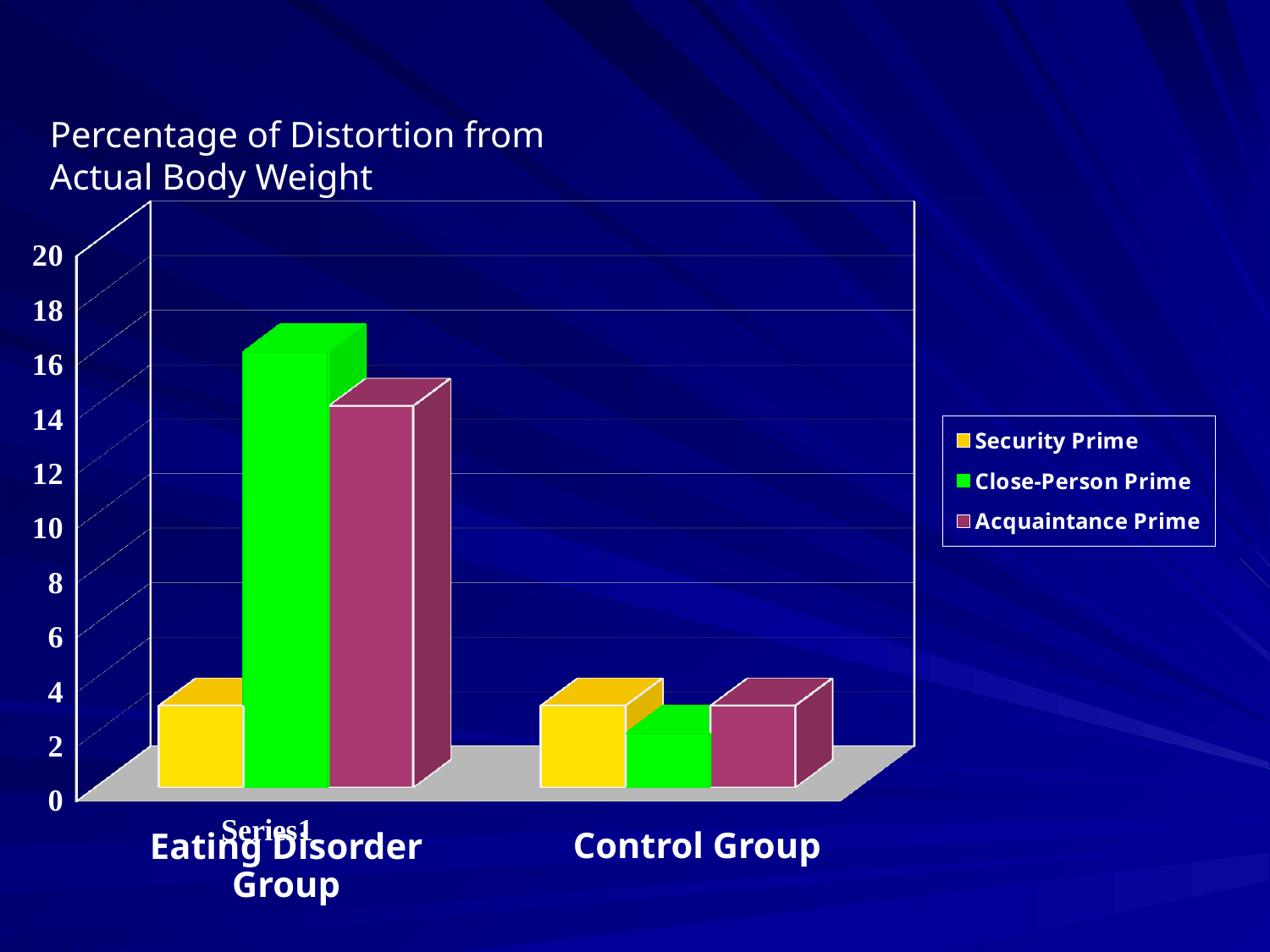
Is the value for Close-Person Prime in the Eating Disorder Group greater or less than 10? greater Within the Eating Disorder Group, which prime condition has the highest value? Close-Person Prime How many series does the legend list? 3 Which is larger: the Close-Person Prime value for the Eating Disorder Group or for the Control Group? Eating Disorder Group Is the value for Security Prime in the Eating Disorder Group greater or less than 6? less What kind of chart is shown on the slide? bar chart What is the title of the chart? Percentage of Distortion from Actual Body Weight Is the value for Acquaintance Prime in the Eating Disorder Group greater or less than 10? greater How many groups (categories) are shown on the x axis? 2 Which colour represents the Close-Person Prime series? green Within the Eating Disorder Group, which prime condition has the lowest value? Security Prime